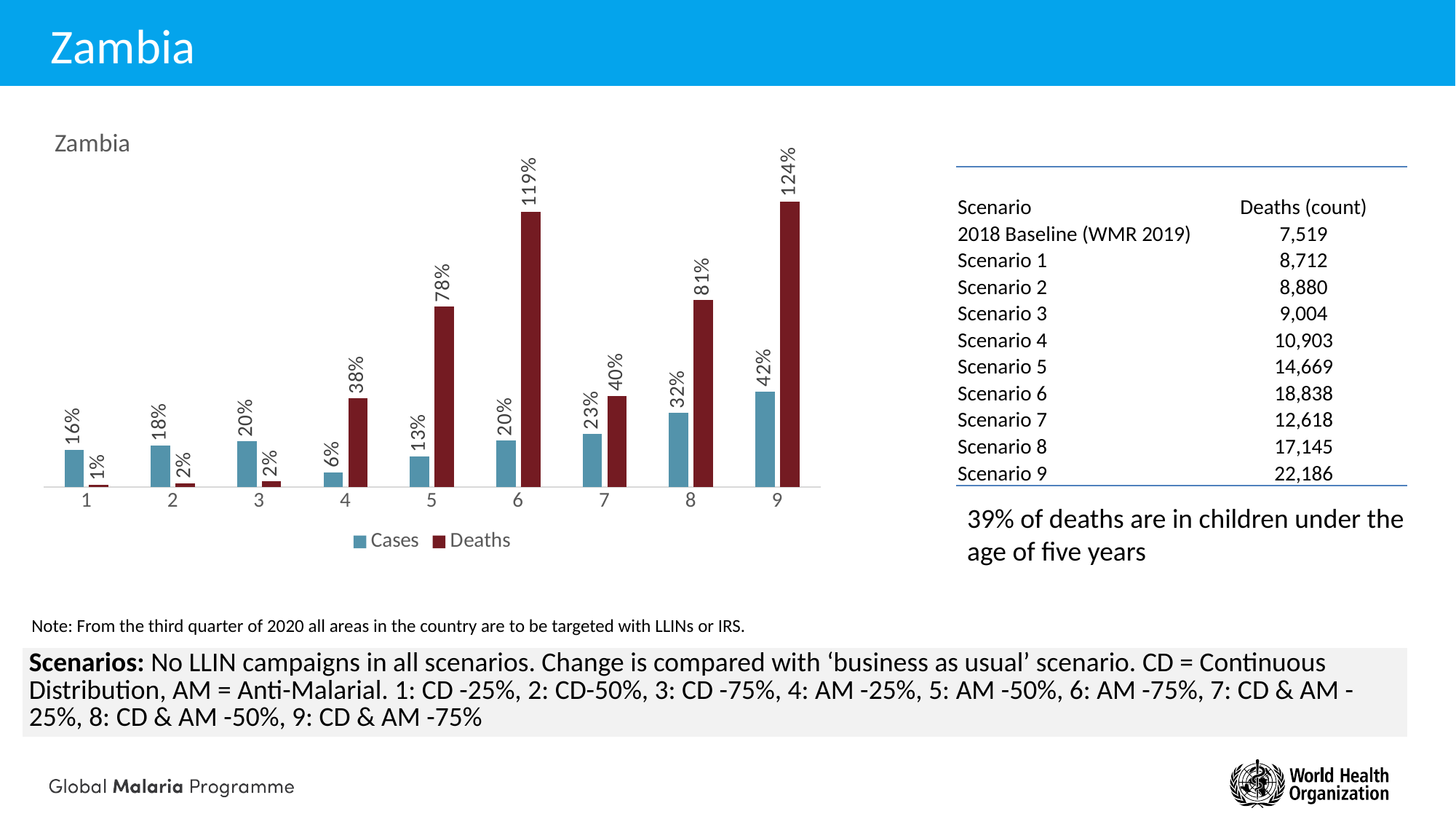
What is the Deaths value for scenario 1? 1% What is the Cases value for scenario 9? 42% Do the Cases values rise or fall from scenario 7 to scenario 9? Rise How many series does the chart legend list? 2 What is the Deaths value for scenario 6? 119% What kind of chart is shown on the slide? Bar chart What are the two series named in the chart legend? Cases and Deaths Which is larger, the Cases value for scenario 8 or the Deaths value for scenario 7? Deaths for scenario 7 How many scenarios are shown on the x axis of the chart? 9 What is the difference between the Deaths values for scenario 9 and scenario 6? 5% Which scenario has the lowest Cases value? 4 Which scenario has the highest Deaths value? 9